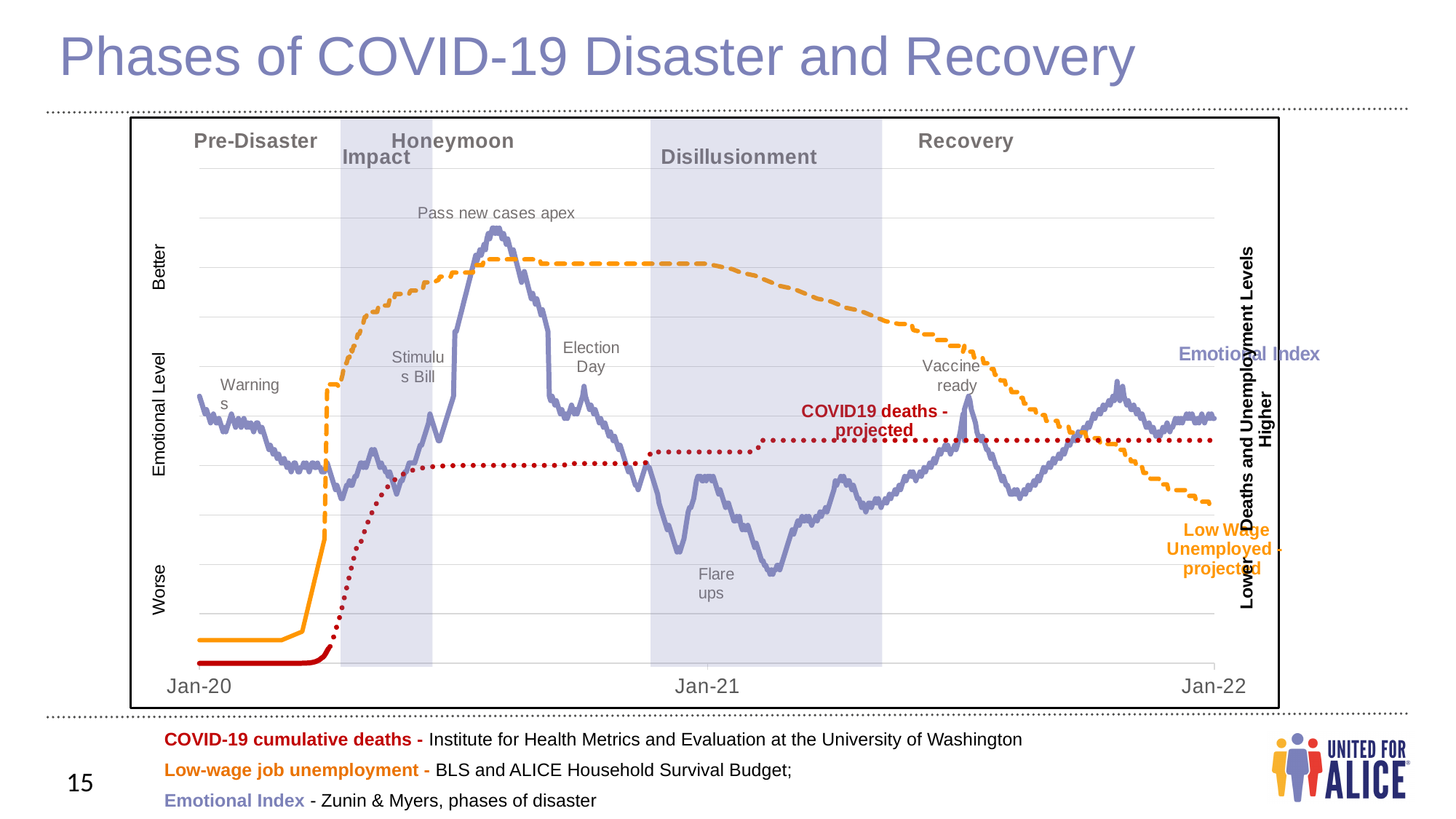
In which phase does the Emotional Index reach its highest point? Honeymoon What are the three dates labelled on the x axis? Jan-20, Jan-21, Jan-22 At Jan-22, is the Low Wage Unemployed - projected line higher or lower than the COVID19 deaths - projected line? Lower Which phase is shaded and labelled between Honeymoon and Recovery? Disillusionment Which annotation marks the lowest point of the Emotional Index line? Flare ups How many disaster phases are labelled across the top of the chart? 5 What kind of chart is shown on the slide? Line chart Does the Emotional Index line rise or fall between the Election Day annotation and the Flare ups annotation? Fall Does the Low Wage Unemployed - projected line rise or fall during the Recovery phase? Fall Does the COVID19 deaths - projected line rise or fall from Jan-20 to Jan-22 overall? Rise Which annotation marks the highest point of the Emotional Index line? Pass new cases apex How many data series are plotted on the chart? 5